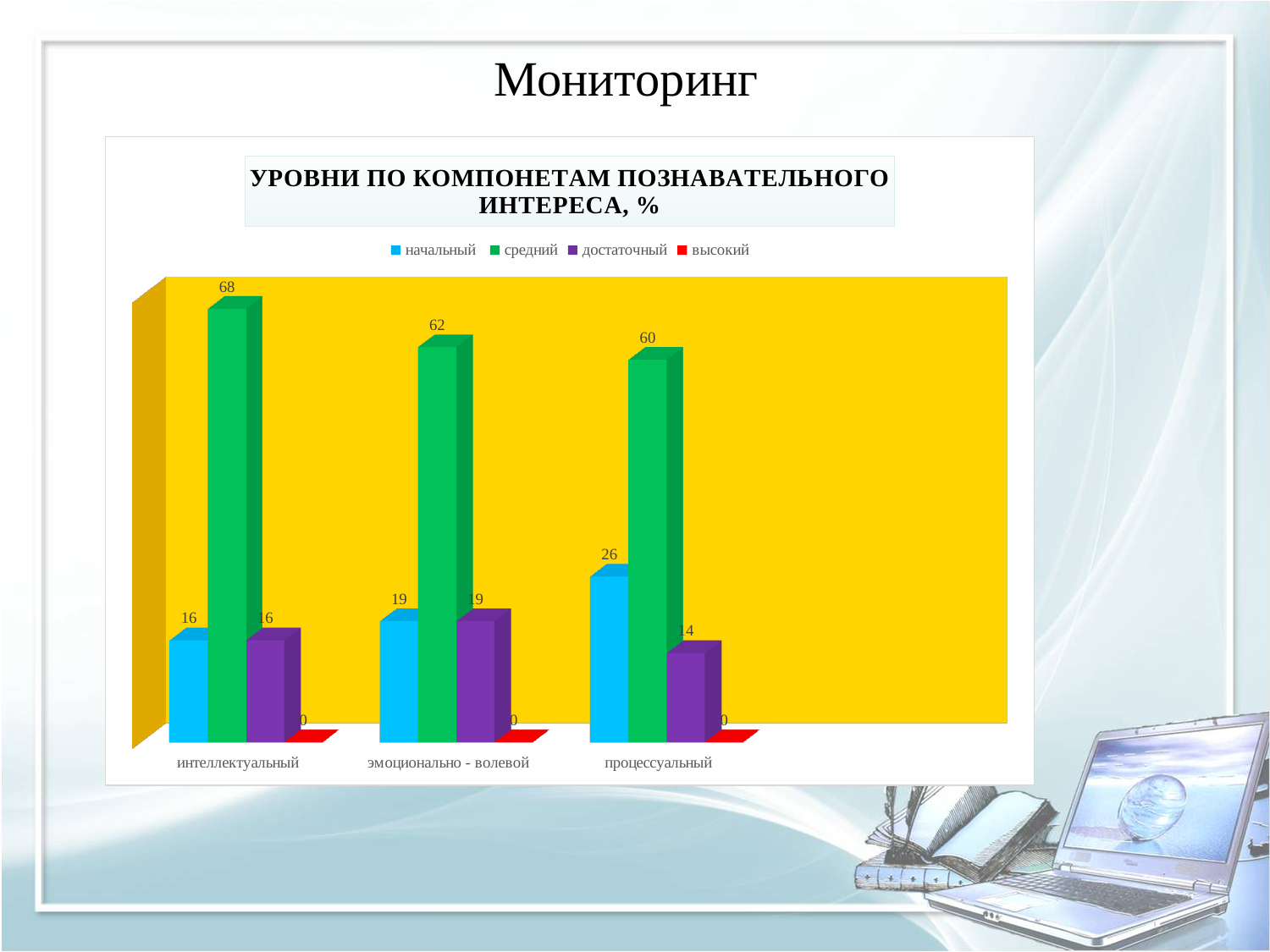
How many series does the legend list? 4 What kind of chart is shown on the slide? bar chart Which category has the highest value for средний? интеллектуальный Which is larger: the начальный value for процессуальный or the начальный value for эмоционально - волевой? процессуальный Which category has the lowest value for начальный? интеллектуальный Which series is shown in red in the legend? высокий What is the difference between the средний values for интеллектуальный and процессуальный? 8 What is the value for средний in the интеллектуальный category? 68 What is the value for достаточный in the эмоционально - волевой category? 19 What is the value for начальный in the процессуальный category? 26 What is the value for достаточный in the процессуальный category? 14 How many categories are shown on the x axis? 3